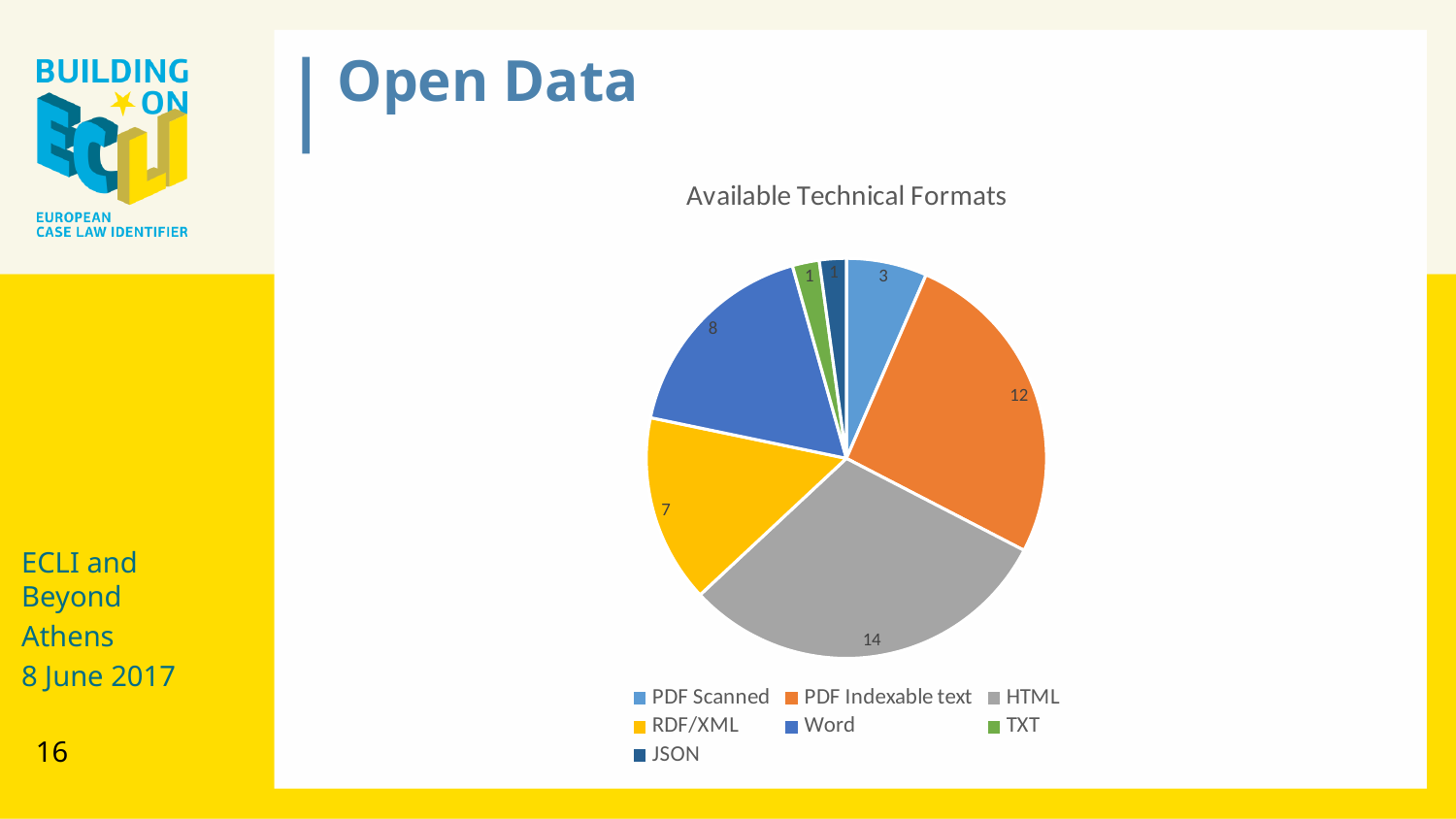
What is the difference between the values for HTML and PDF Indexable text? 2 Which is larger, the value for Word or the value for RDF/XML? Word What is the value for Word? 8 What is the value for HTML? 14 Which formats have the smallest value in the chart? TXT and JSON What type of chart is shown on the slide? pie chart How many categories does the legend list? 7 What is the title of the chart? Available Technical Formats Which format has the largest slice of the pie? HTML What is the value for PDF Indexable text? 12 What is the value for RDF/XML? 7 What is the value for PDF Scanned? 3